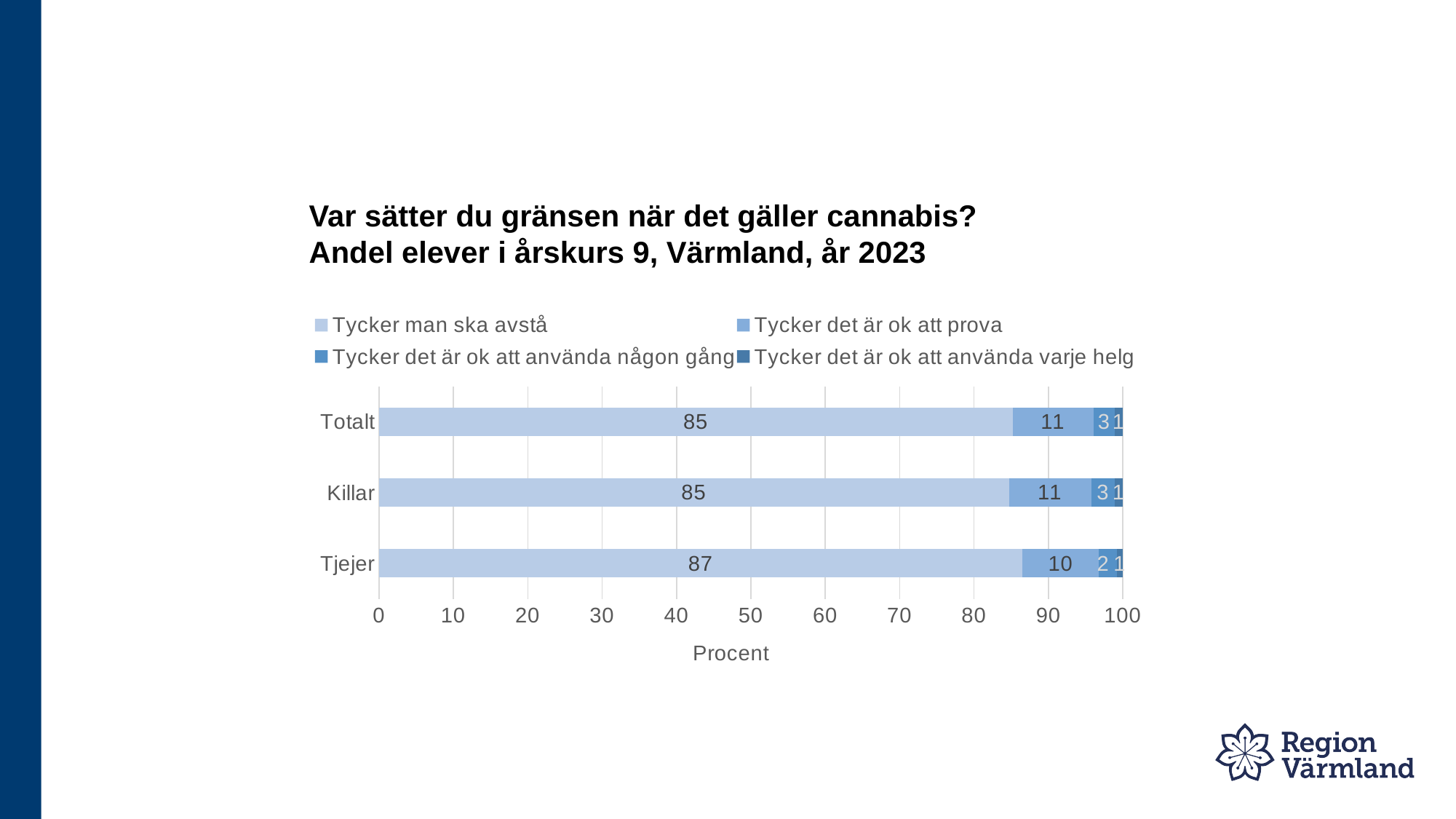
Which category has the lowest value for 'Tycker det är ok att prova'? Tjejer How many categories are shown on the vertical axis of the chart? 3 What is the difference between the 'Tycker man ska avstå' values for Tjejer and Killar? 2 Which category has the highest value for 'Tycker man ska avstå'? Tjejer How many series does the legend list? 4 What is the label of the horizontal axis? Procent What is the value for 'Tycker det är ok att använda någon gång' for Totalt? 3 What is the value for 'Tycker det är ok att prova' for Killar? 11 What kind of chart is shown on the slide? Stacked bar chart What is the value for 'Tycker man ska avstå' for Tjejer? 87 What is the value for 'Tycker det är ok att använda varje helg' for Tjejer? 1 Which is larger: the 'Tycker det är ok att använda någon gång' value for Killar or for Tjejer? Killar